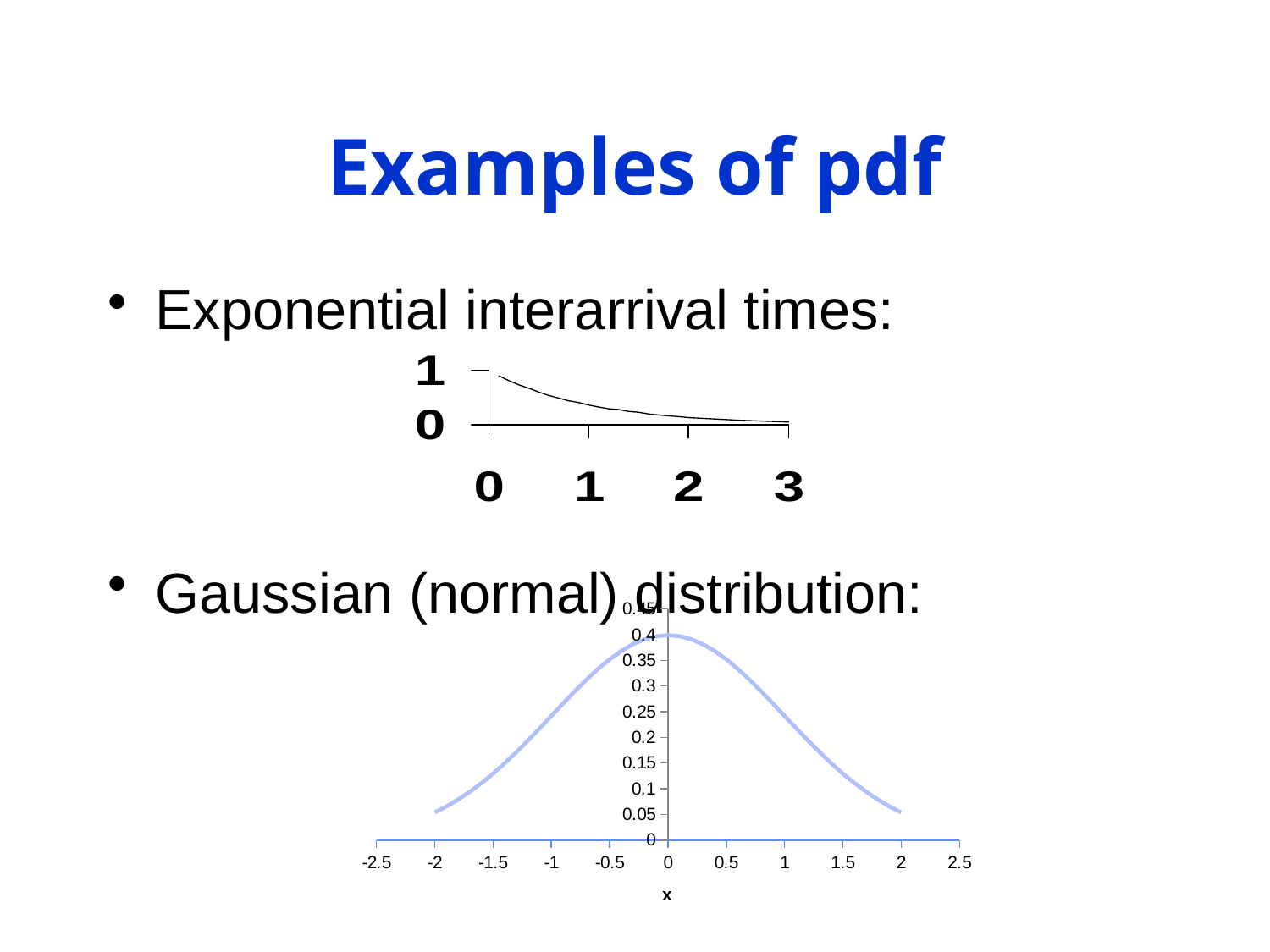
In the bottom chart (Gaussian distribution), is the value at x = 1 greater or less than 0.3? less In the bottom chart (Gaussian distribution), do the values rise or fall as x goes from 0 to 2? fall What kind of chart is the top chart under 'Exponential interarrival times'? line chart In the top chart (exponential interarrival times), do the values rise or fall as x increases from 0 to 3? fall What is the x-axis title of the bottom chart (Gaussian distribution)? x In the bottom chart (Gaussian distribution), at which x value does the curve reach its highest point? 0 In the top chart (exponential interarrival times), is the value at x = 3 greater or less than 0.5? less In the bottom chart (Gaussian distribution), which is larger: the value at x = 0.5 or the value at x = 1.5? x = 0.5 In the bottom chart (Gaussian distribution), do the values rise or fall as x goes from -2 to 0? rise In the bottom chart (Gaussian distribution), is the value at x = 2 greater or less than 0.1? less What kind of chart is the bottom chart under 'Gaussian (normal) distribution'? line chart